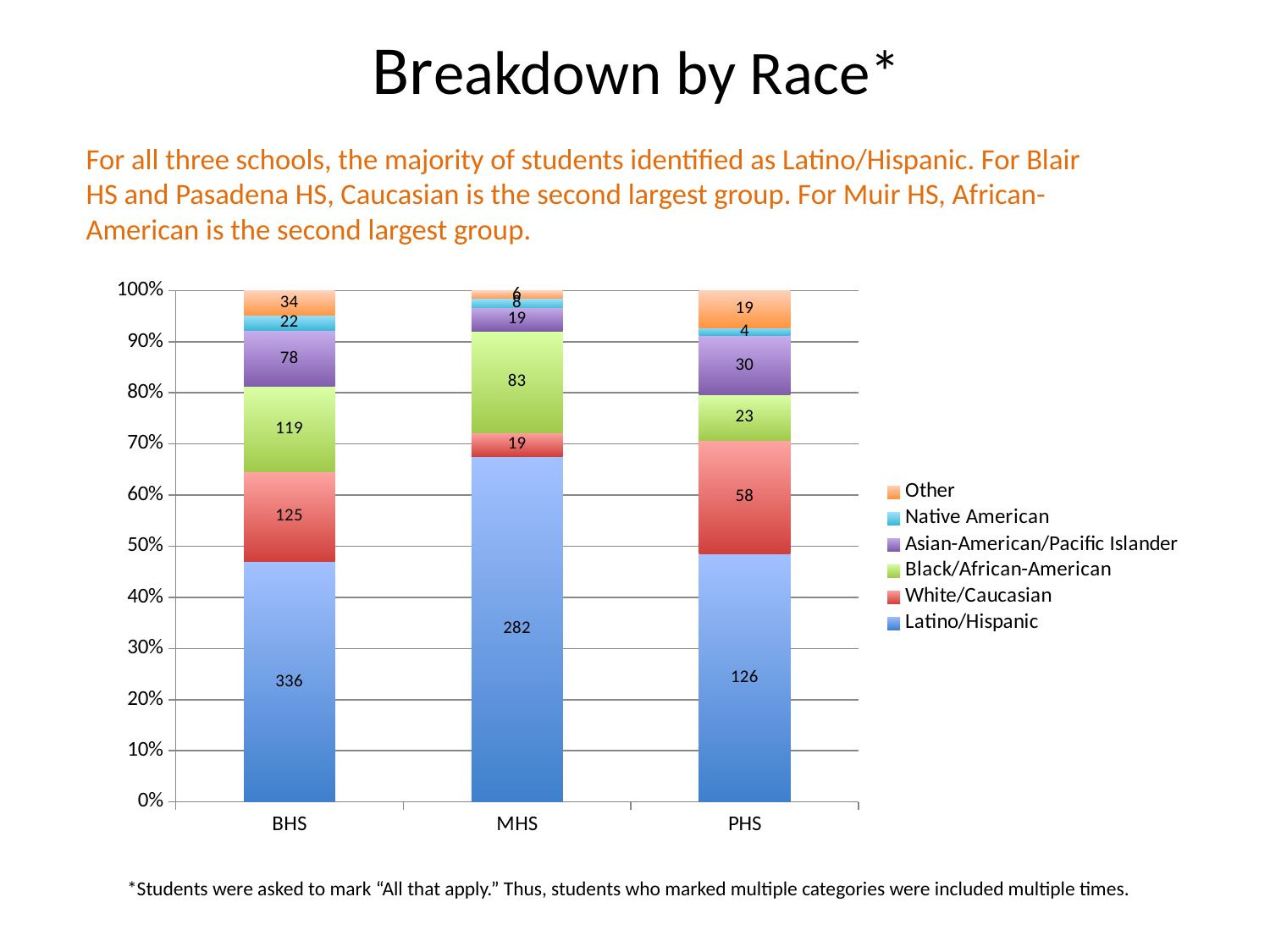
What is the value for Latino/Hispanic at BHS? 336 How many series does the legend list? 6 Which school has the lowest Native American count? PHS Is the Latino/Hispanic share of the MHS bar greater or less than 60%? greater How many schools are shown on the x axis? 3 What is the difference between the White/Caucasian and Black/African-American values at BHS? 6 What is the value for White/Caucasian at PHS? 58 Which school has the highest Latino/Hispanic count? BHS Which is larger, the Black/African-American value at MHS or at PHS? MHS What is the value for Black/African-American at MHS? 83 What is the total of all values in the BHS bar? 714 What is the value for Asian-American/Pacific Islander at BHS? 78